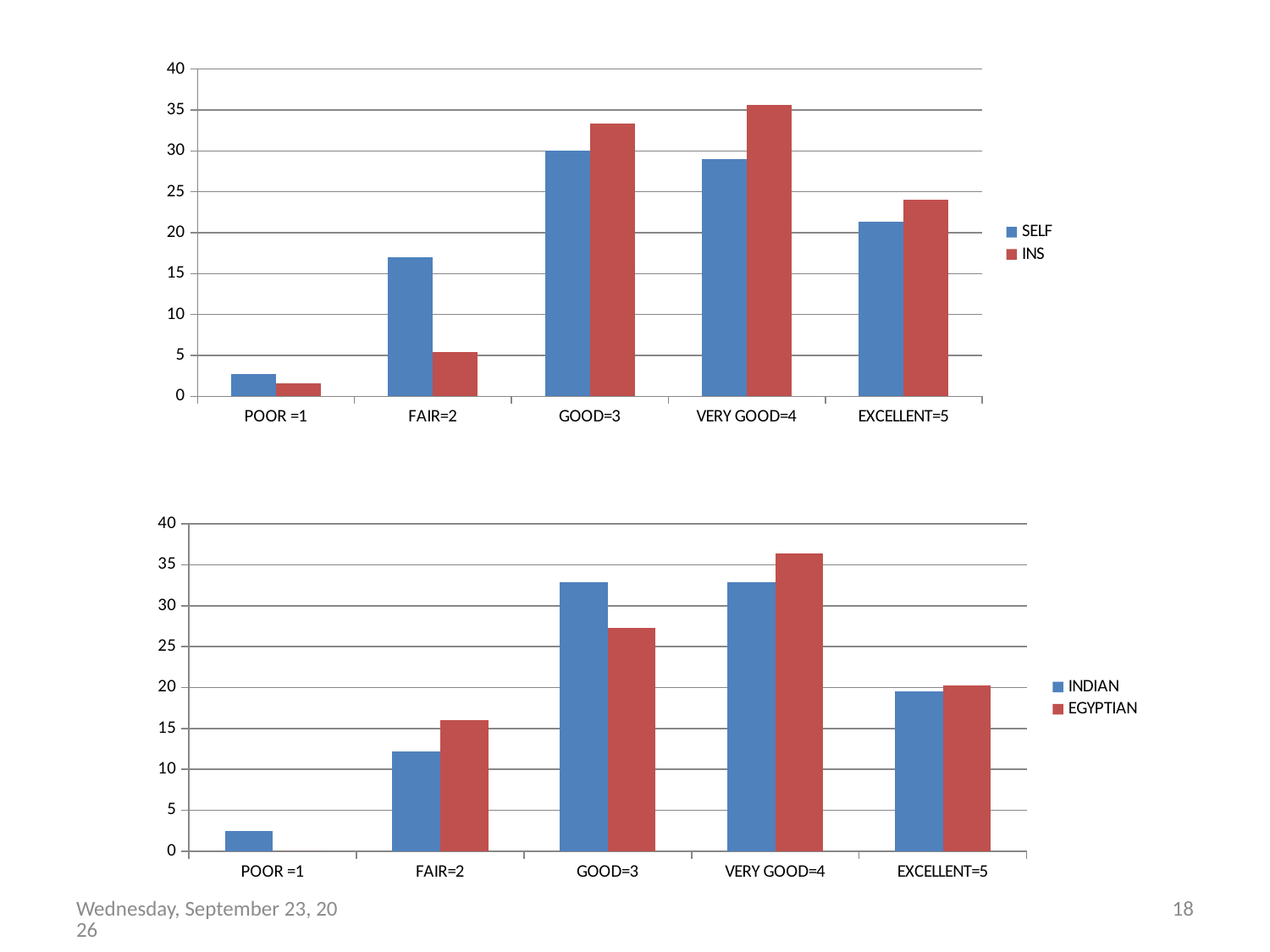
In the top chart, which category has the highest INS value? VERY GOOD=4 In the top chart, is the SELF value for FAIR=2 greater or less than 15? greater In the bottom chart, for GOOD=3, which series has the larger value, INDIAN or EGYPTIAN? INDIAN What are the two series named in the legend of the bottom chart? INDIAN and EGYPTIAN In the bottom chart, which category has the highest EGYPTIAN value? VERY GOOD=4 How many series does the legend of the top chart list? 2 In the top chart, for FAIR=2, which series has the larger value, SELF or INS? SELF What kind of chart is the top chart on the slide? bar chart How many categories are shown on the x axis of the bottom chart? 5 In the top chart, is the INS value for FAIR=2 greater or less than 10? less In the bottom chart, is the INDIAN value for FAIR=2 greater or less than 15? less In the top chart, which category has the lowest SELF value? POOR =1